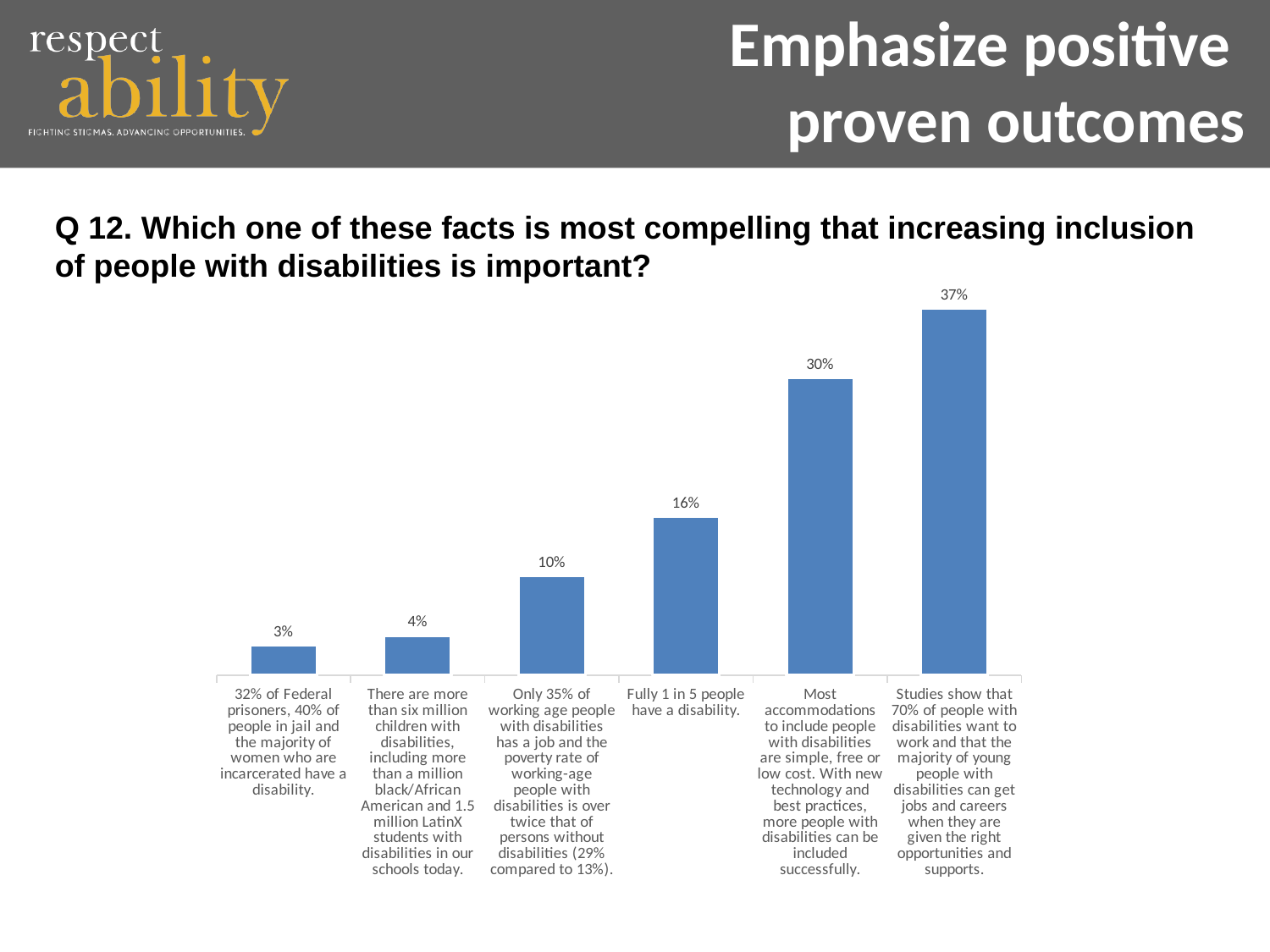
What percentage is shown for the fact that 32% of Federal prisoners have a disability? 3% Which fact received the lowest percentage of responses? 32% of Federal prisoners, 40% of people in jail and the majority of women who are incarcerated have a disability. What kind of chart is shown on the slide? Bar chart What survey question does the chart present results for? Q 12. Which one of these facts is most compelling that increasing inclusion of people with disabilities is important? What is the difference in percentage points between the highest bar (37%) and the bar for most accommodations being simple (30%)? 7 percentage points What percentage of respondents chose "Fully 1 in 5 people have a disability" as the most compelling fact? 16% Which has a larger value: the bar about six million children with disabilities or the bar about only 35% of working age people with disabilities having a job? Only 35% of working age people with disabilities has a job and the poverty rate of working-age people with disabilities is over twice that of persons without disabilities (29% compared to 13%). What is the combined percentage of the two lowest bars (3% and 4%)? 7% Do the values rise or fall from left to right across the chart? Rise How many categories (facts) are shown in the chart? 6 What is the value for the bar about most accommodations being simple, free or low cost? 30%